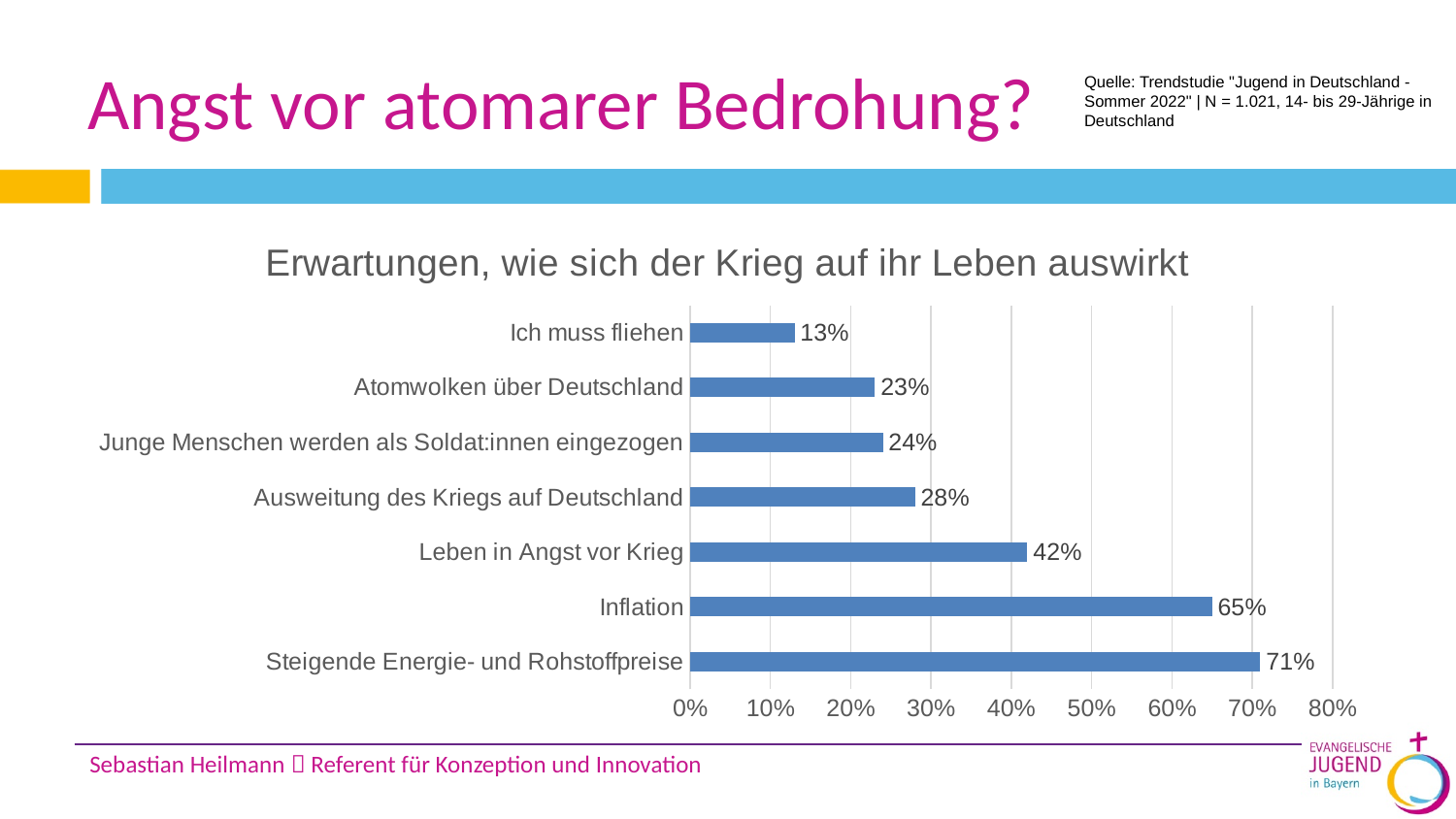
Which is larger, the value for "Ausweitung des Kriegs auf Deutschland" or the value for "Junge Menschen werden als Soldat:innen eingezogen"? Ausweitung des Kriegs auf Deutschland Which category has the highest value? Steigende Energie- und Rohstoffpreise How many categories are shown in the chart? 7 Is the value for "Leben in Angst vor Krieg" greater or less than 50%? less What is the value for "Leben in Angst vor Krieg"? 42% What is the difference between the values for "Steigende Energie- und Rohstoffpreise" and "Inflation"? 6% What is the value for "Atomwolken über Deutschland"? 23% What is the difference between the values for "Leben in Angst vor Krieg" and "Ausweitung des Kriegs auf Deutschland"? 14% What kind of chart is shown on the slide? bar chart What is the title of the chart? Erwartungen, wie sich der Krieg auf ihr Leben auswirkt What is the value for "Inflation"? 65% Which category has the lowest value? Ich muss fliehen